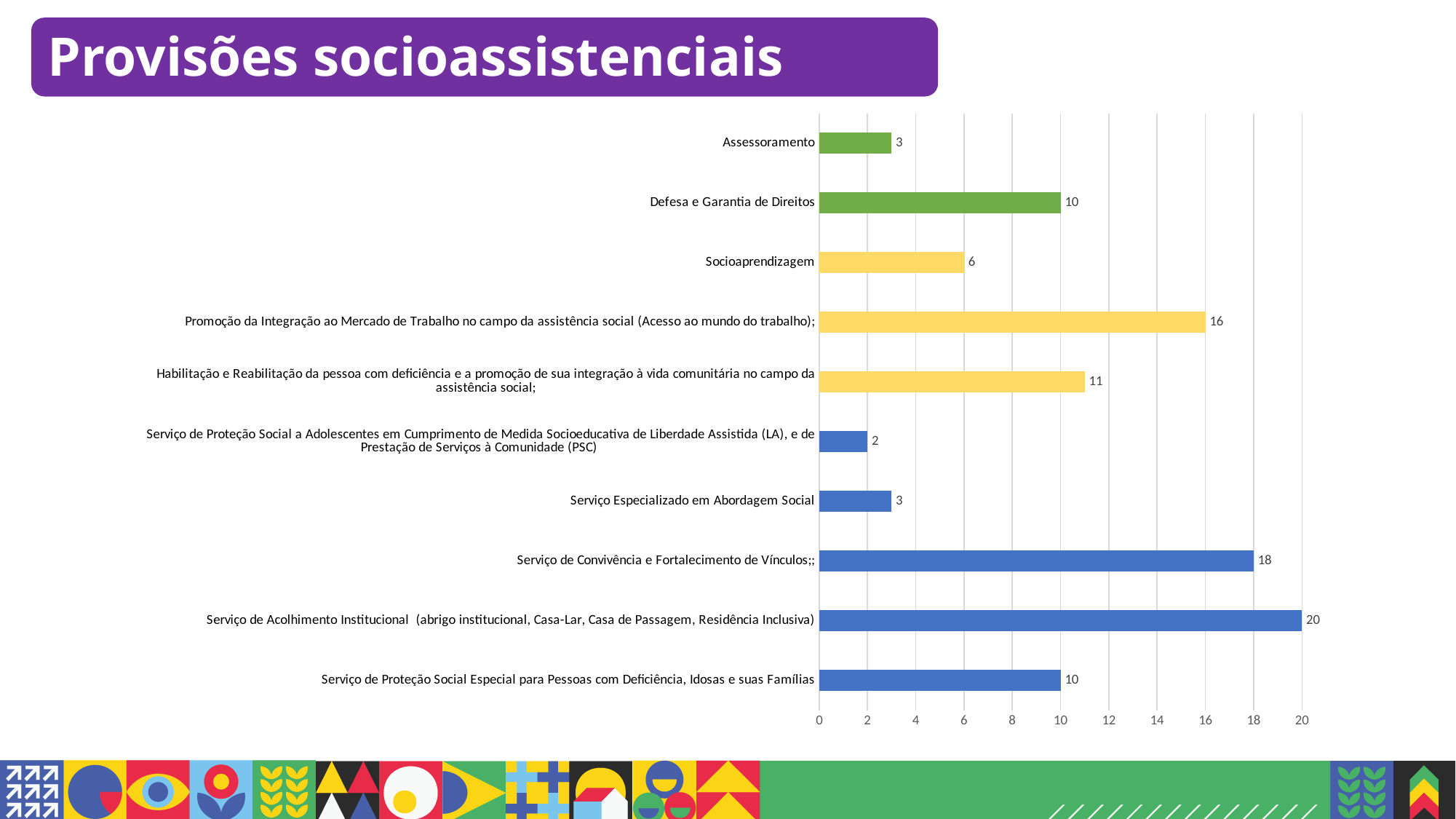
What is the value for Socioaprendizagem? 6 How many categories are shown in the chart? 10 What is the value for Serviço de Convivência e Fortalecimento de Vínculos? 18 Which is larger: the value for Habilitação e Reabilitação da pessoa com deficiência or the value for Defesa e Garantia de Direitos? Habilitação e Reabilitação da pessoa com deficiência What is the value for Assessoramento? 3 What is the difference between the value for Promoção da Integração ao Mercado de Trabalho and the value for Socioaprendizagem? 10 What is the title of the slide? Provisões socioassistenciais What is the value for Defesa e Garantia de Direitos? 10 Which category has the highest value? Serviço de Acolhimento Institucional (abrigo institucional, Casa-Lar, Casa de Passagem, Residência Inclusiva) What kind of chart is shown on the slide? Bar chart What colour are the bars for Assessoramento and Defesa e Garantia de Direitos? Green Which category has the lowest value? Serviço de Proteção Social a Adolescentes em Cumprimento de Medida Socioeducativa de Liberdade Assistida (LA), e de Prestação de Serviços à Comunidade (PSC)